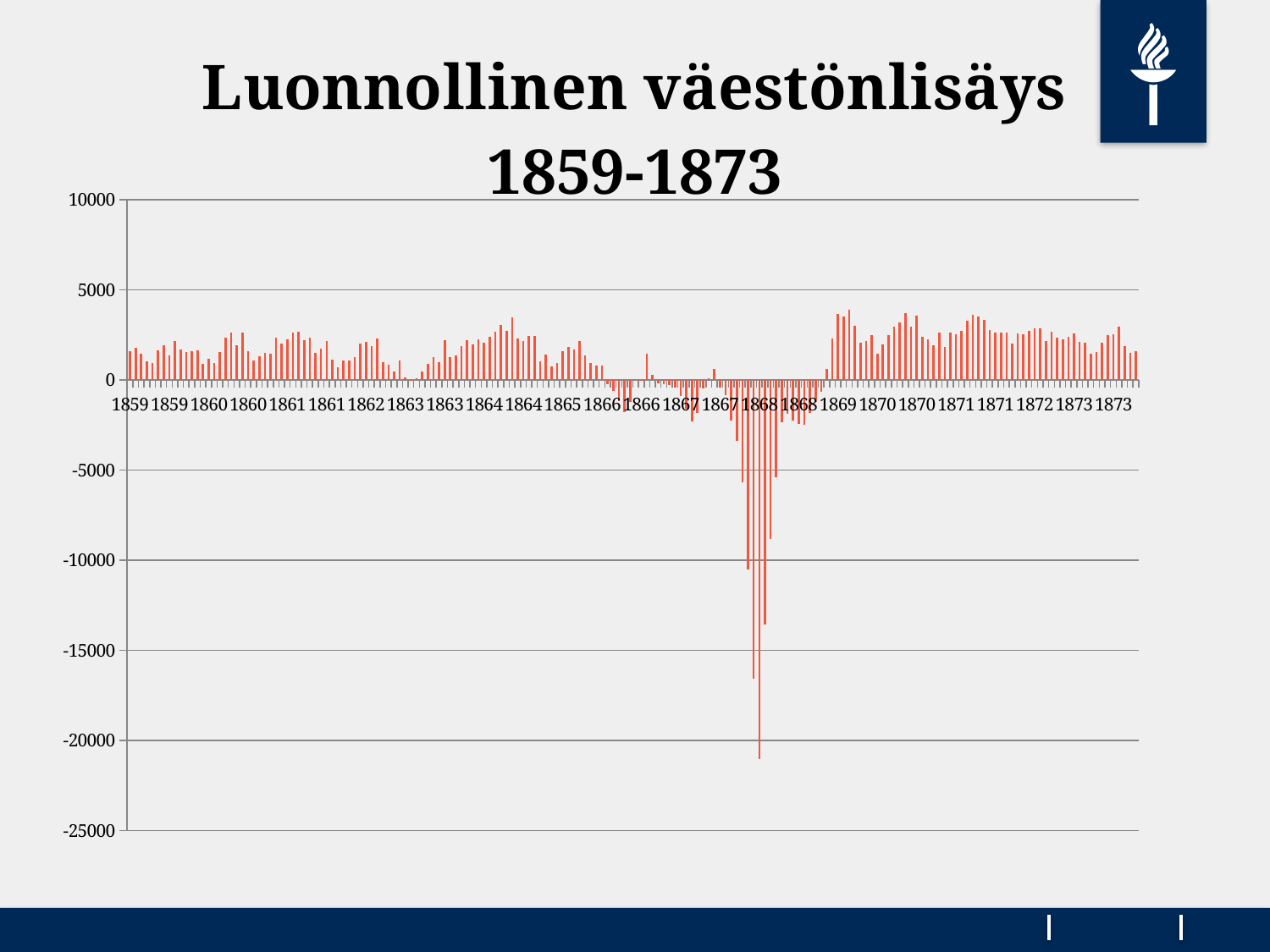
Is the highest value on the chart greater or less than 5000? less What kind of chart is shown on the slide? bar chart Are the values for 1870 greater or less than 0? greater In which year does the lowest bar of the chart occur? 1868 Which year has larger values overall, 1868 or 1869? 1869 Do the values fall or rise from 1867 into 1868? fall What colour are the bars in the chart? red What is the title of the chart? Luonnollinen väestönlisäys 1859-1873 Are the values for 1868 mostly greater or less than 0? less